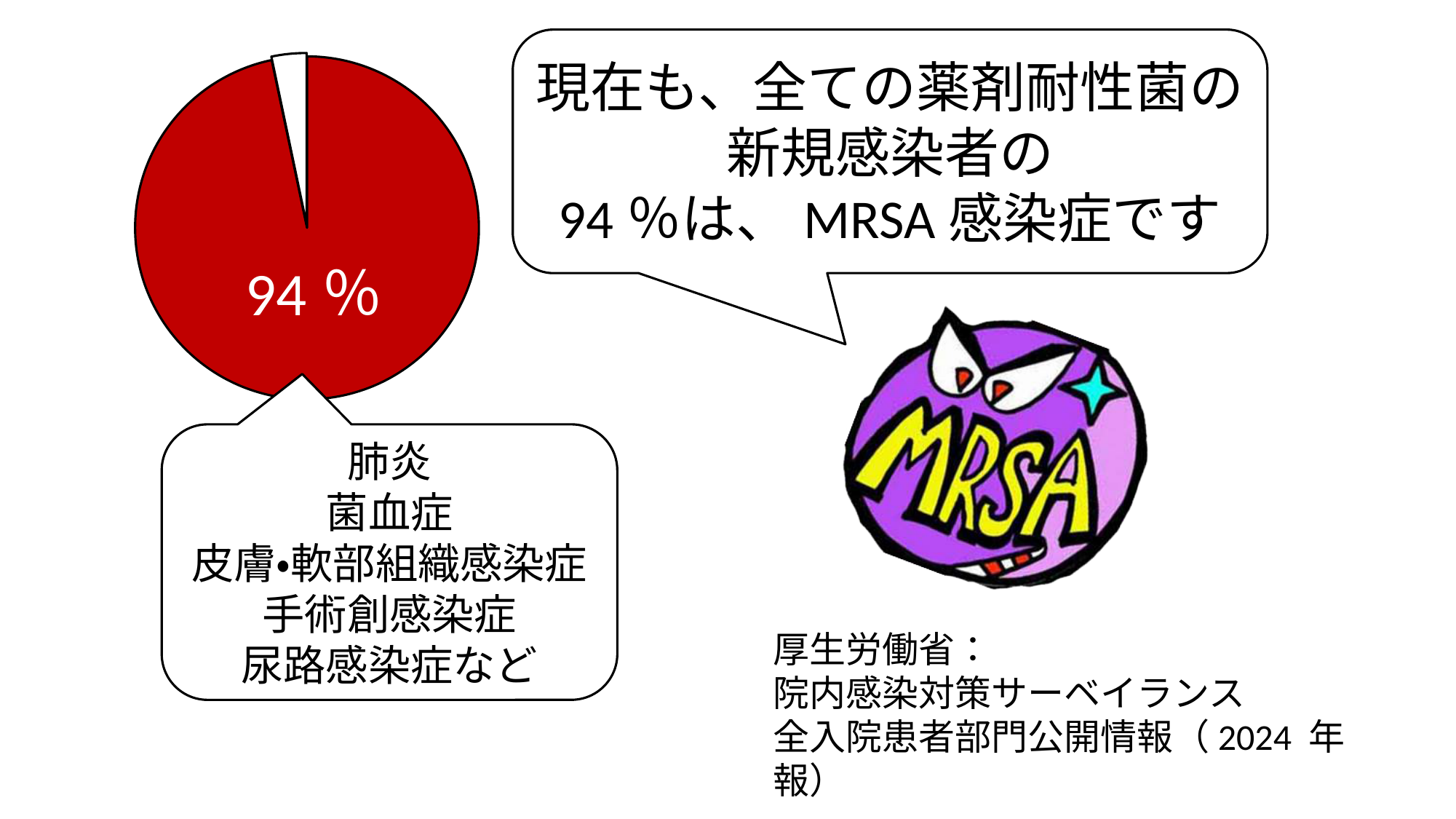
Which slice of the pie chart is larger, the red slice or the white slice? the red slice According to the slide, what does the 94 % slice of the pie chart represent? MRSA 感染症 (the share of new drug-resistant bacterial infections that are MRSA) How many slices does the pie chart have? 2 What kind of chart is shown on the slide? pie chart What colour is the slice labelled 94 % in the pie chart? red What share of the pie does the red slice represent? 94 % What value is printed on the large red slice of the pie chart? 94 %